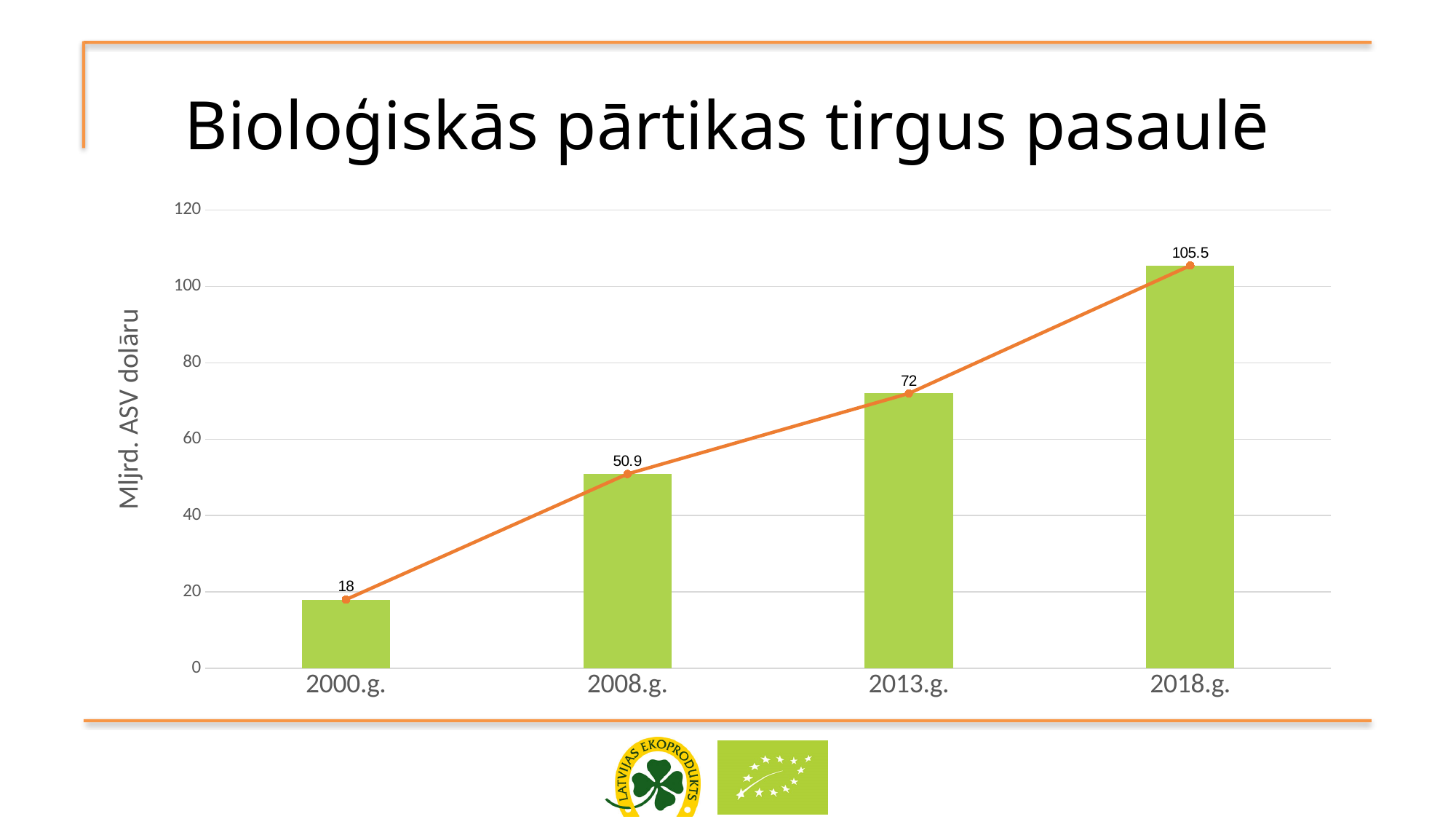
What is the difference between the values for 2008.g. and 2000.g.? 32.9 How many years are shown on the x axis? 4 Which year has the highest value? 2018.g. Which year has the lowest value? 2000.g. What is the difference between the values for 2018.g. and 2013.g.? 33.5 What is the value for 2013.g.? 72 What is the value for 2000.g.? 18 Which is larger, the value for 2013.g. or the value for 2008.g.? 2013.g. Do the values rise or fall from 2000.g. to 2018.g.? rise What is the y-axis label of the chart? Mljrd. ASV dolāru What is the value for 2008.g.? 50.9 What is the value for 2018.g.? 105.5